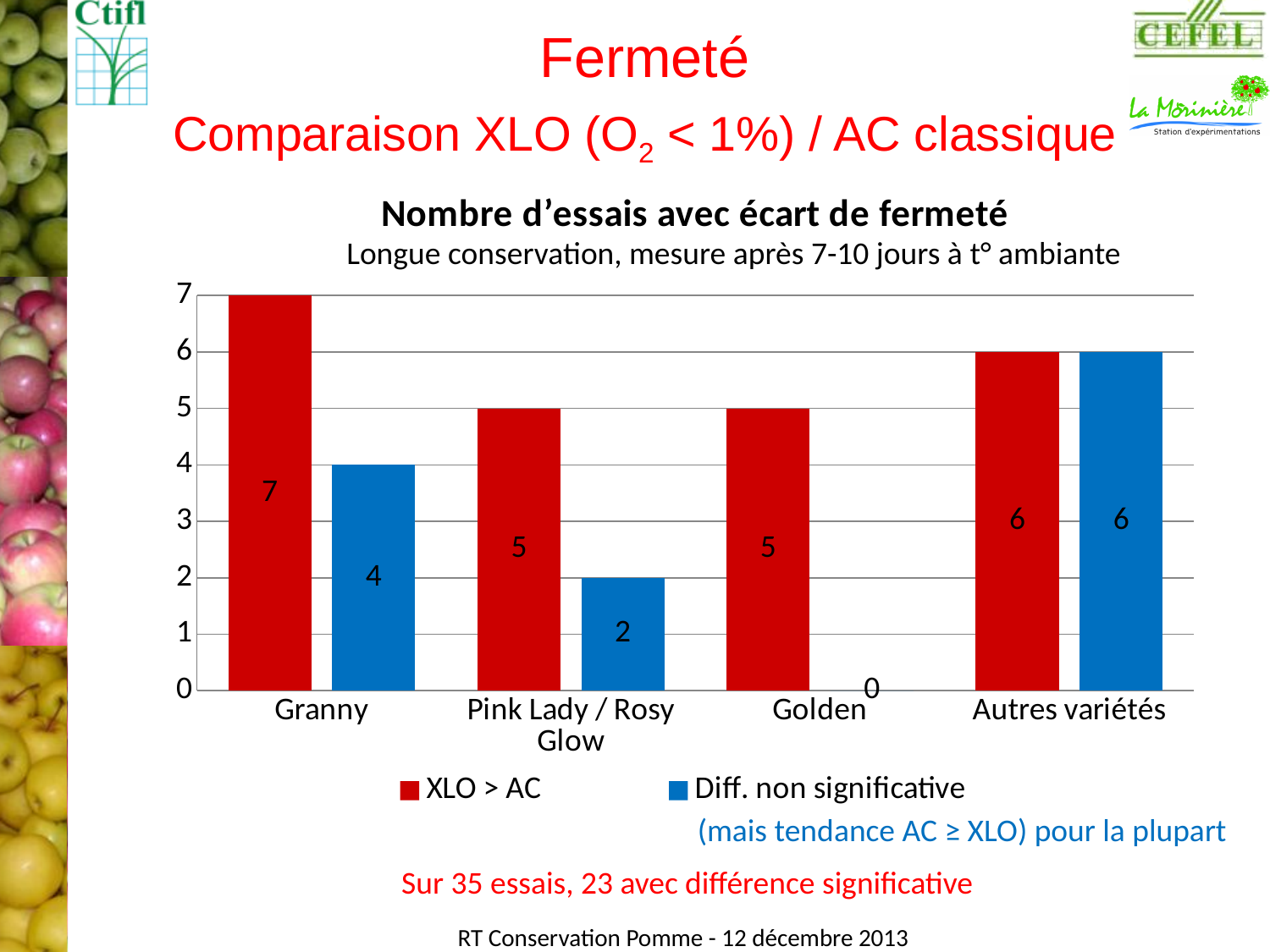
What colour are the bars for the XLO > AC series? red What kind of chart is shown on the slide? bar chart What is the difference between the XLO > AC and Diff. non significative values for Granny? 3 What is the value for Pink Lady / Rosy Glow in the Diff. non significative series? 2 What is the value for Granny in the XLO > AC series? 7 How many categories are shown on the x axis? 4 Which category has the highest value in the XLO > AC series? Granny How many series does the legend list? 2 Which category has the lowest value in the Diff. non significative series? Golden What is the title of the chart? Nombre d'essais avec écart de fermeté For Pink Lady / Rosy Glow, which series has the larger value, XLO > AC or Diff. non significative? XLO > AC What is the value for Golden in the Diff. non significative series? 0